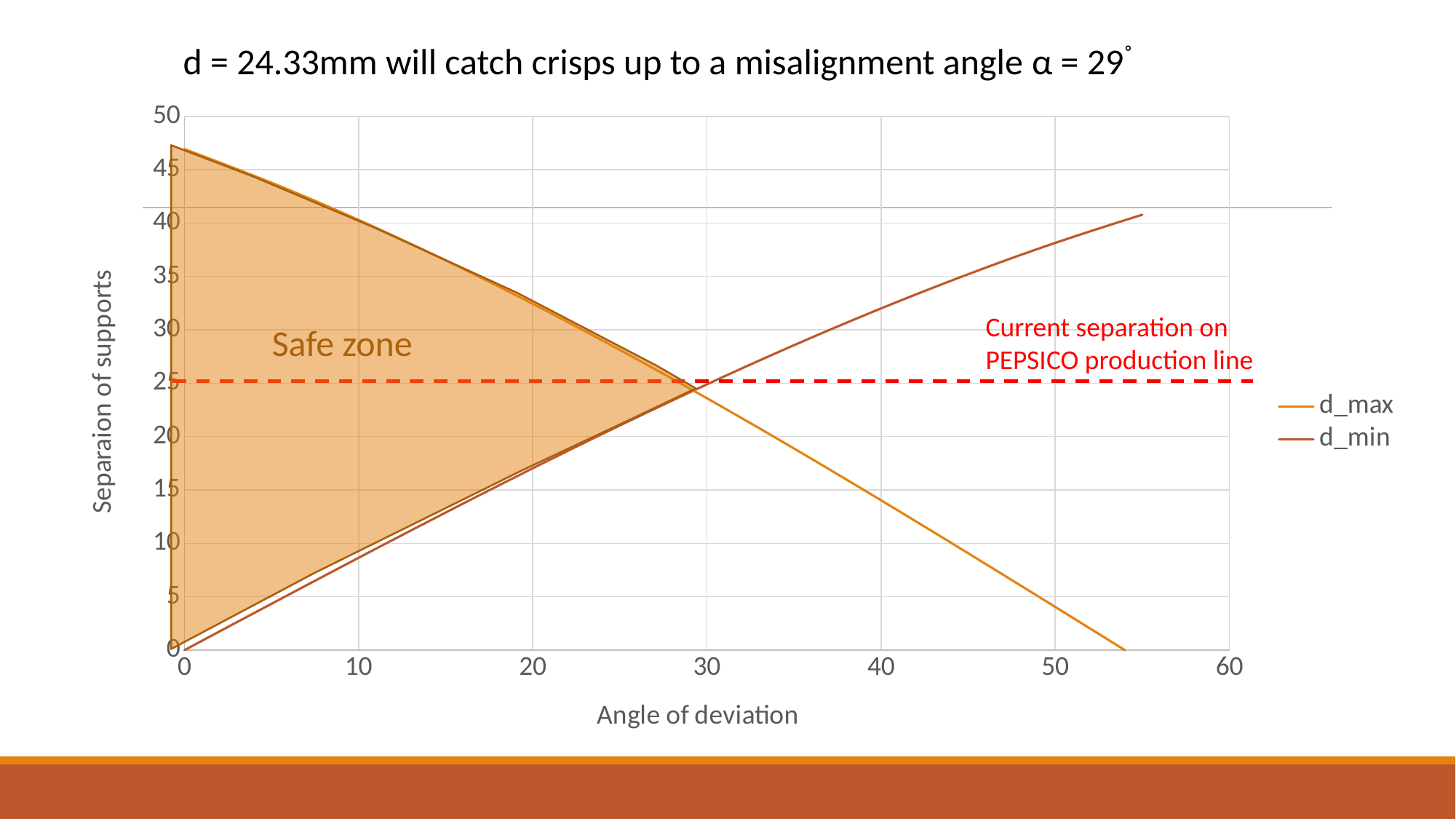
Is the value of d_max at an angle of deviation of 0 greater or less than 45? greater At an angle of deviation of 40, which series has the larger value, d_max or d_min? d_min Which series are listed in the legend? d_max and d_min At an angle of deviation of 10, which series has the larger value, d_max or d_min? d_max How many series does the legend list? 2 What is the title of the x axis? Angle of deviation Is the value of d_min at an angle of deviation of 10 greater or less than 10? less What kind of chart is shown on the slide? line chart Does the d_min series rise or fall as the angle of deviation increases? rise Is the value of d_min at an angle of deviation of 0 greater or less than 5? less Does the d_max series rise or fall as the angle of deviation increases? fall